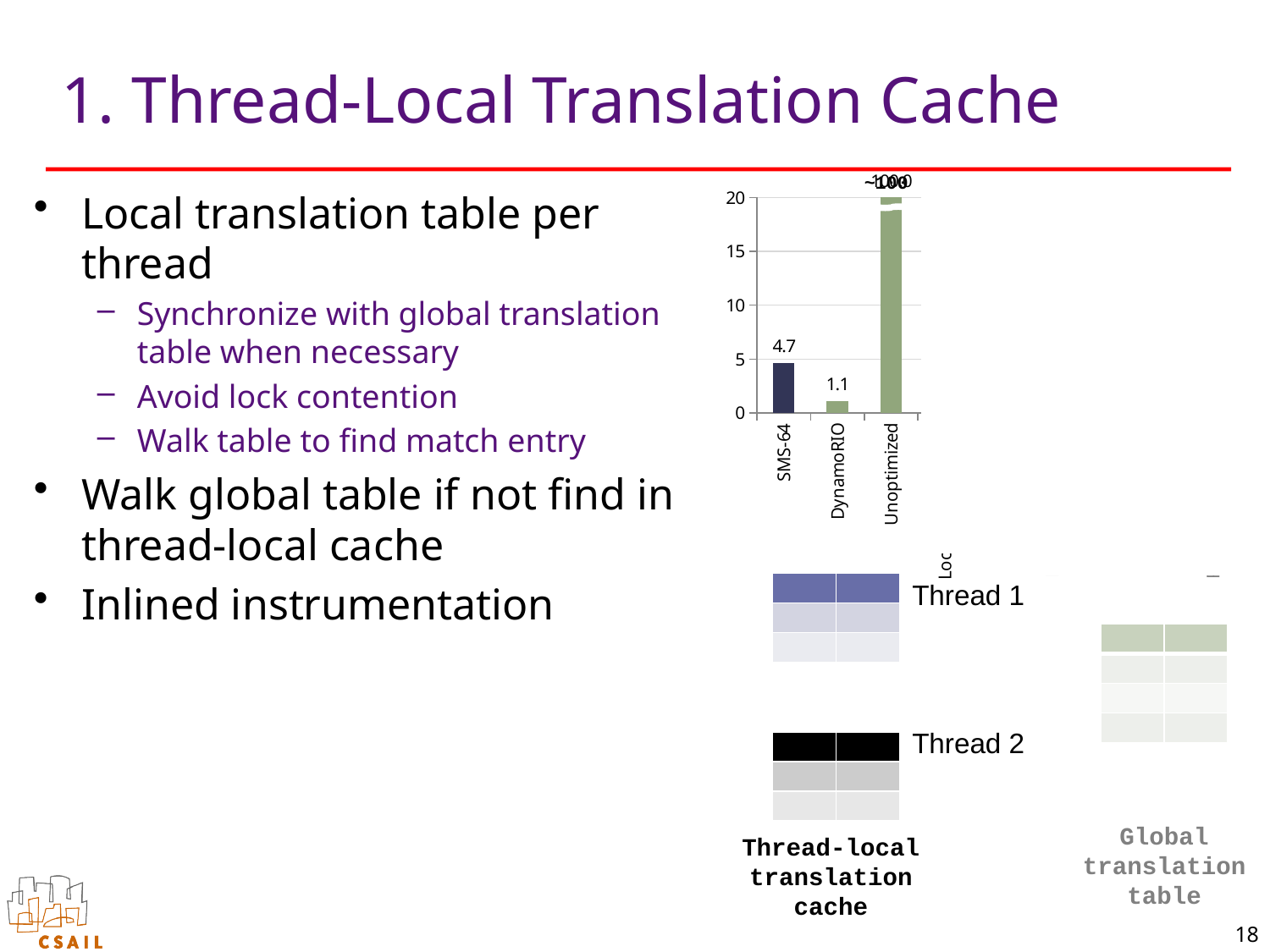
Is the value for Unoptimized greater or less than 20? greater Which category has the highest bar in the chart? Unoptimized What kind of chart is shown on the slide? bar chart What is the highest tick value printed on the y axis of the chart? 20 Which category has the lowest bar in the chart? DynamoRIO What is the value shown for DynamoRIO in the bar chart? 1.1 Which is larger, the value for SMS-64 or the value for DynamoRIO? SMS-64 What colour is the bar for Unoptimized? green Is the value for DynamoRIO greater or less than 5? less How many categories are shown on the x axis of the bar chart? 3 What is the difference between the values for SMS-64 and DynamoRIO? 3.6 What is the value shown for SMS-64 in the bar chart? 4.7